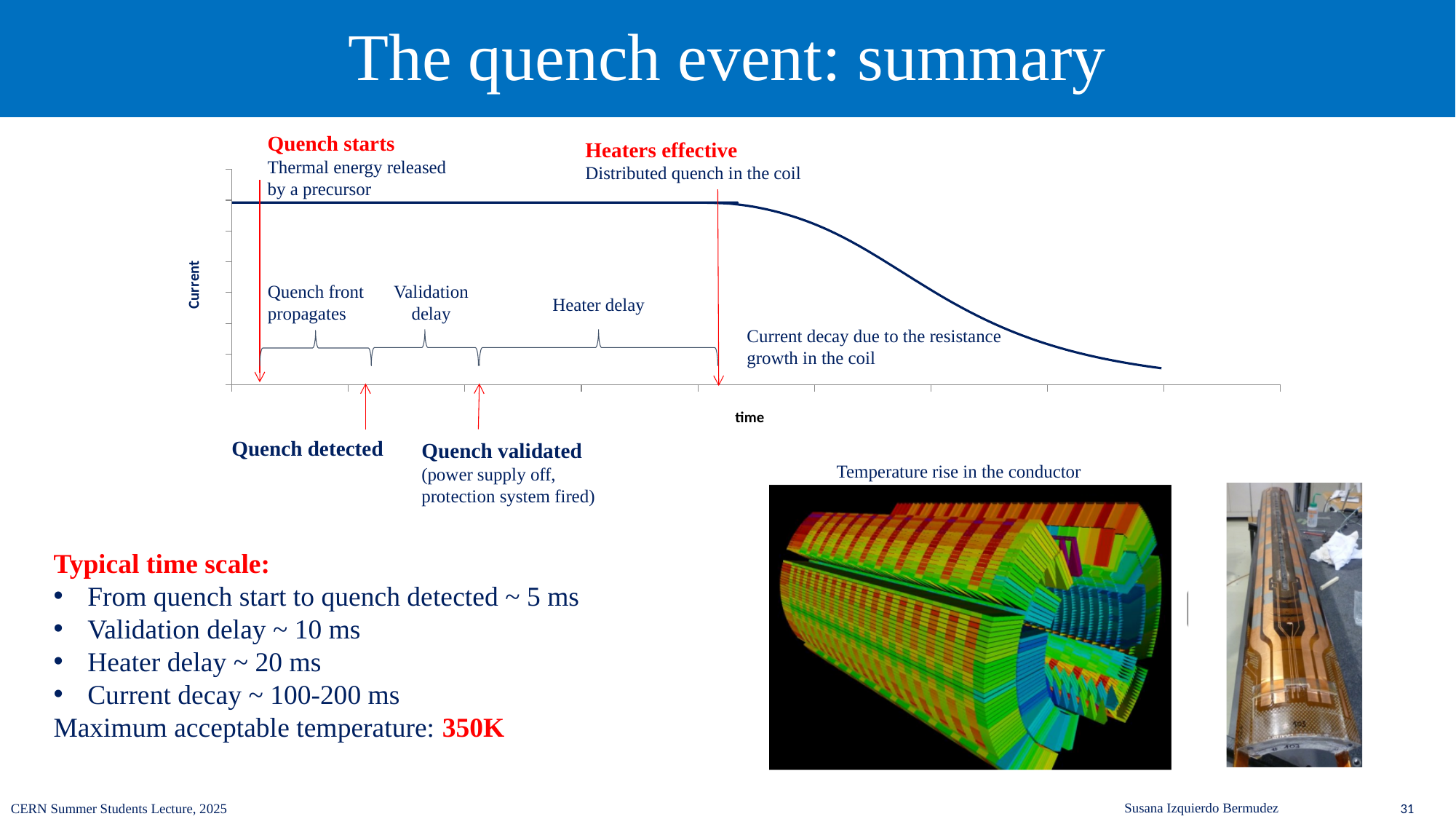
Between 'Quench starts' and 'Heaters effective', does the current rise, fall, or stay flat? stay flat What is the label of the horizontal axis of the chart? time What kind of chart is shown on the slide? line chart What is the label of the vertical axis of the chart? Current How many plotted lines (series) does the chart show? 1 After the point marked 'Heaters effective', does the current rise or fall along the time axis? fall How many bracketed time intervals are labelled below the current line before the heaters become effective? 3